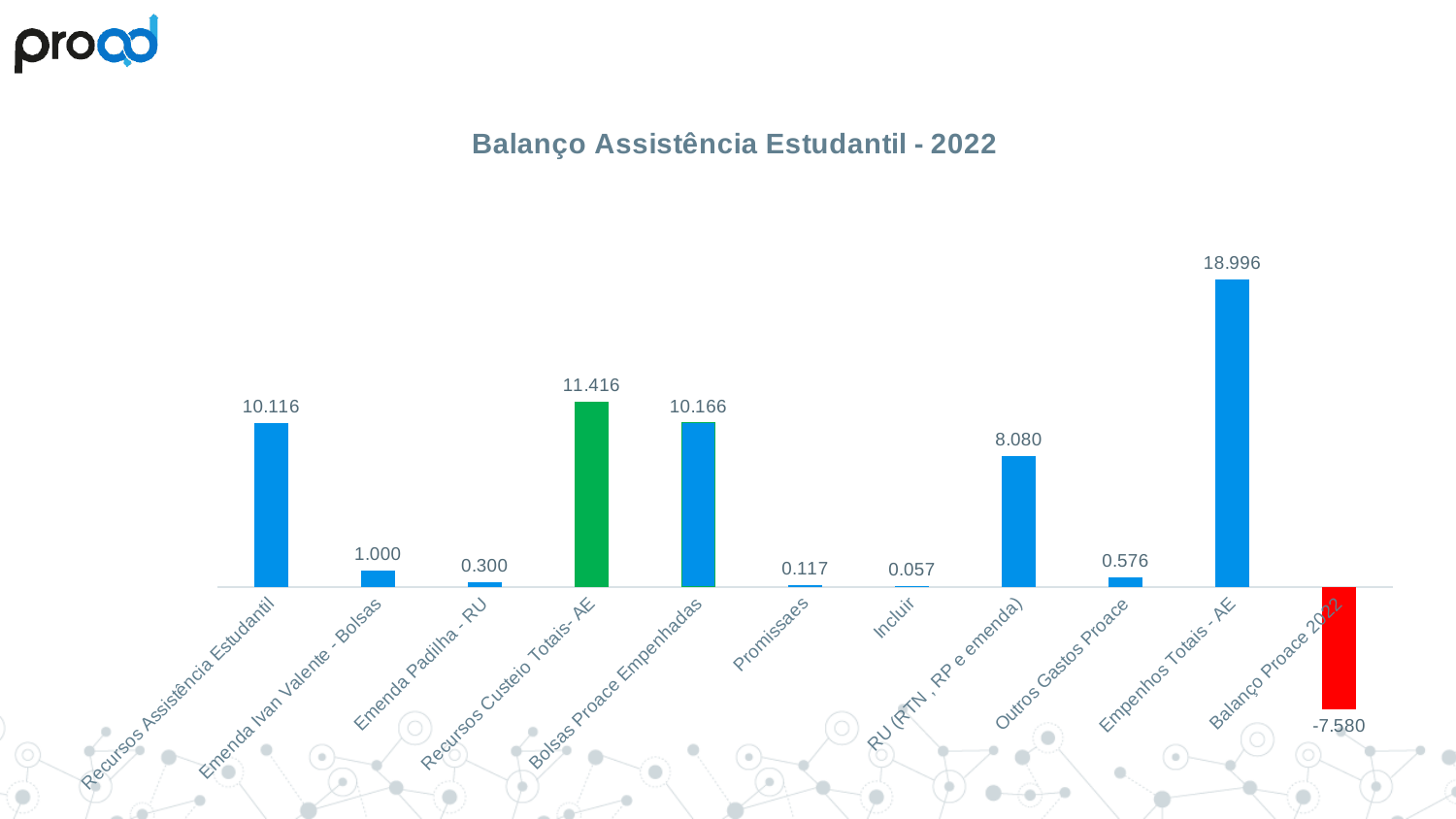
What is the value for Balanço Proace 2022? -7.580 What is the value for Recursos Custeio Totais- AE? 11.416 What is the value for Recursos Assistência Estudantil? 10.116 Which is larger, Bolsas Proace Empenhadas or RU (RTN, RP e emenda)? Bolsas Proace Empenhadas What is the value for RU (RTN, RP e emenda)? 8.080 How many categories are shown in the chart? 11 What is the title of the chart? Balanço Assistência Estudantil - 2022 Which category has the highest value? Empenhos Totais - AE What is the difference between Empenhos Totais - AE and Recursos Custeio Totais- AE? 7.580 Which category has the lowest value? Balanço Proace 2022 What is the value for Empenhos Totais - AE? 18.996 What kind of chart is shown on the slide? Bar chart